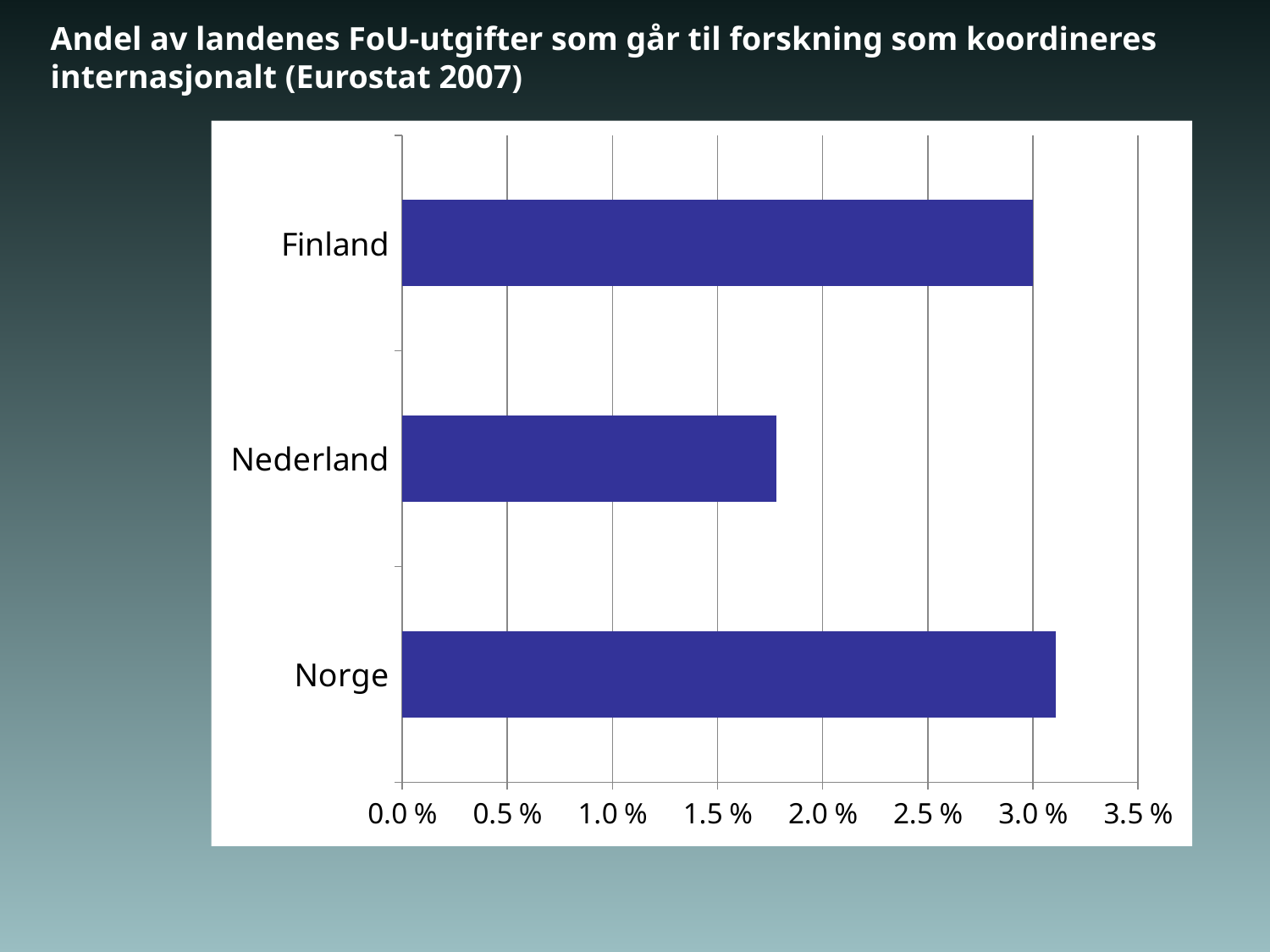
Which source and year are cited in the slide title? Eurostat 2007 Is the value for Nederland greater or less than 1.5 %? greater How many countries are shown in the chart? 3 What kind of chart is shown on the slide? bar chart Is the value for Norge greater or less than 3.5 %? less Is the value for Finland greater or less than 2.5 %? greater What is the highest value shown on the x axis of the chart? 3.5 % Which is larger, the value for Norge or the value for Nederland? Norge Which is larger, the value for Finland or the value for Nederland? Finland Which country has the lowest share of R&D expenditure going to internationally coordinated research? Nederland